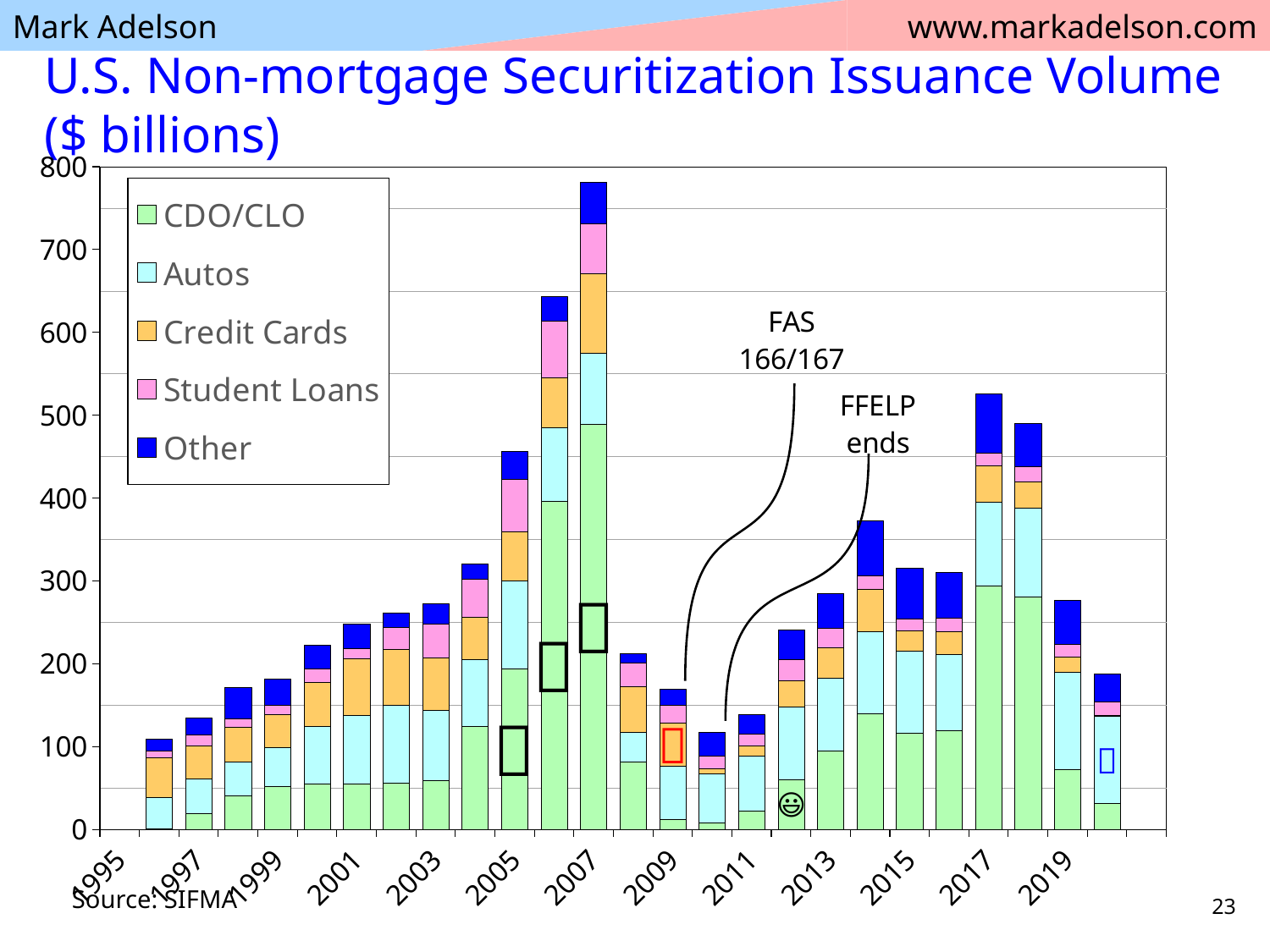
What kind of chart is shown on the slide? Stacked bar chart Is the total issuance volume for 2007 greater or less than 700? greater How many years (bars) are plotted in the chart? 25 Is the total issuance volume for 2017 greater or less than 500? greater What is the source cited for the chart data? SIFMA Is the total issuance volume for 2020 greater or less than 200? less Which year has the highest total non-mortgage securitization issuance volume? 2007 How many series does the legend list? 5 Which year has the larger total issuance volume, 2019 or 2020? 2019 Which year has the larger total issuance volume, 2006 or 2007? 2007 Does the total issuance volume rise or fall from 1996 to 2007? Rise